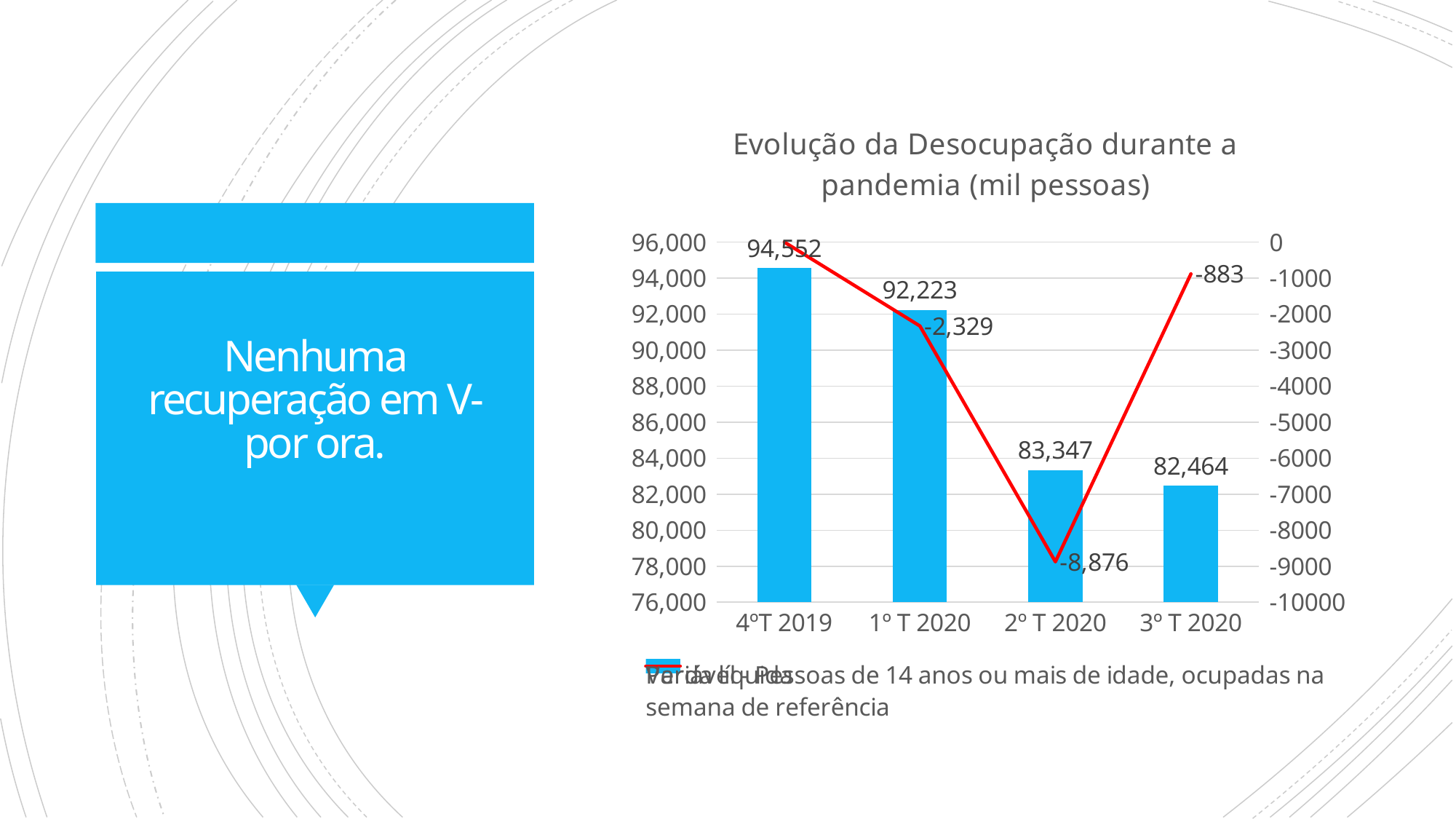
At which quarter does the red line reach its lowest point? 2º T 2020 What is the bar value for 4ºT 2019? 94,552 How many quarters are shown on the x axis? 4 What is the title of the chart? Evolução da Desocupação durante a pandemia (mil pessoas) Which quarter has the highest bar? 4ºT 2019 What is the difference between the bar values for 4ºT 2019 and 1º T 2020? 2,329 What is the bar value for 3º T 2020? 82,464 Which bar is taller, 1º T 2020 or 2º T 2020? 1º T 2020 Do the bar values rise or fall from 4ºT 2019 to 3º T 2020? fall Which quarter has the lowest bar? 3º T 2020 What value does the red line show at 2º T 2020? -8,876 What value does the red line show at 3º T 2020? -883